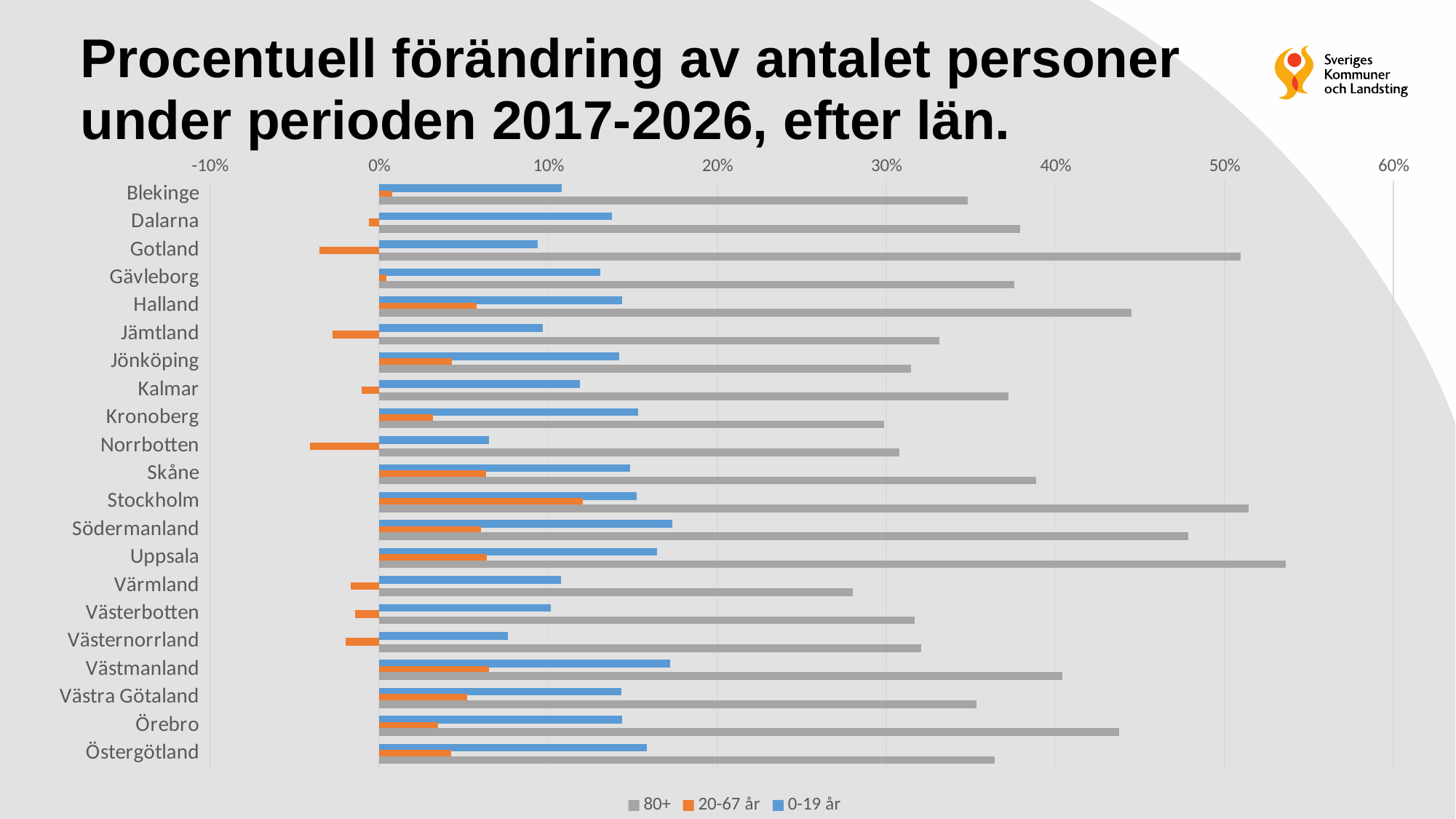
Is the 20-67 år value for Stockholm greater or less than 10%? greater Which is larger, the 80+ value for Stockholm or the 80+ value for Blekinge? Stockholm Which county has the highest value for the 20-67 år series? Stockholm Is the 80+ value for Värmland greater or less than 30%? less How many counties (län) are shown on the chart? 21 Which series is shown in orange in the legend? 20-67 år Which county has the lowest value for the 20-67 år series? Norrbotten How many series does the legend list? 3 What kind of chart is shown on the slide? bar chart Which county has the highest value for the 80+ series? Uppsala Is the 80+ value for Gotland greater or less than 50%? greater Which county has the lowest value for the 0-19 år series? Norrbotten